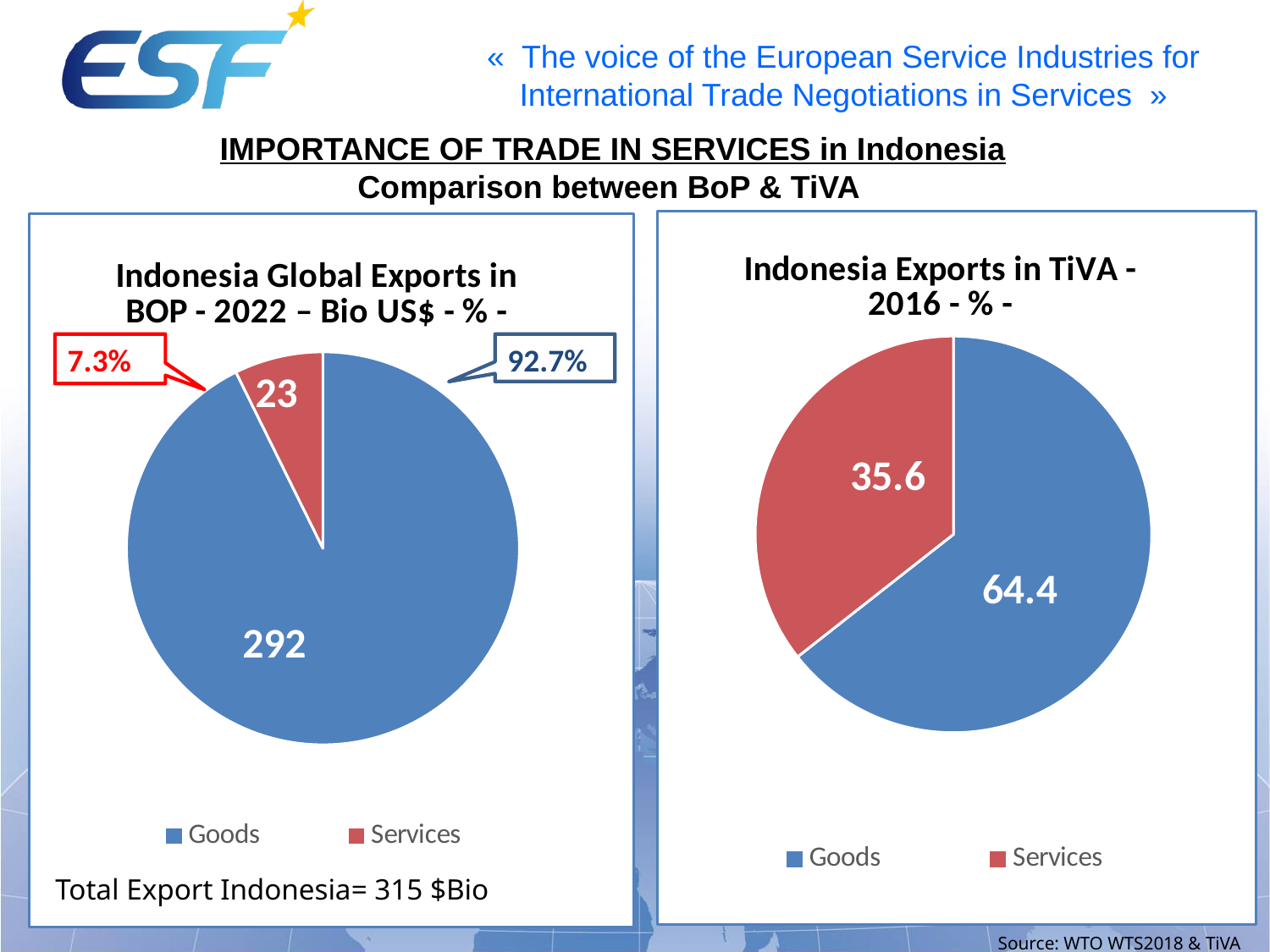
How many categories does the legend of the 'Indonesia Global Exports in BOP - 2022' chart list? 2 In the 'Indonesia Exports in TiVA - 2016' chart, what is the value for Services? 35.6 What kind of chart is the 'Indonesia Exports in TiVA - 2016' chart? Pie chart In the 'Indonesia Exports in TiVA - 2016' chart, which category is the largest? Goods In the 'Indonesia Global Exports in BOP - 2022' chart, which colour represents Services? Red In the 'Indonesia Global Exports in BOP - 2022' chart, what is the difference between the Goods and Services values? 269 In the 'Indonesia Global Exports in BOP - 2022' chart, what is the value for Goods? 292 In the 'Indonesia Global Exports in BOP - 2022' chart, what is the value for Services? 23 In the 'Indonesia Global Exports in BOP - 2022' chart, what percentage share does Goods have? 92.7% In the 'Indonesia Exports in TiVA - 2016' chart, what is the difference between the Goods and Services values? 28.8 In the 'Indonesia Global Exports in BOP - 2022' chart, what percentage share does Services have? 7.3% In the 'Indonesia Exports in TiVA - 2016' chart, what is the value for Goods? 64.4